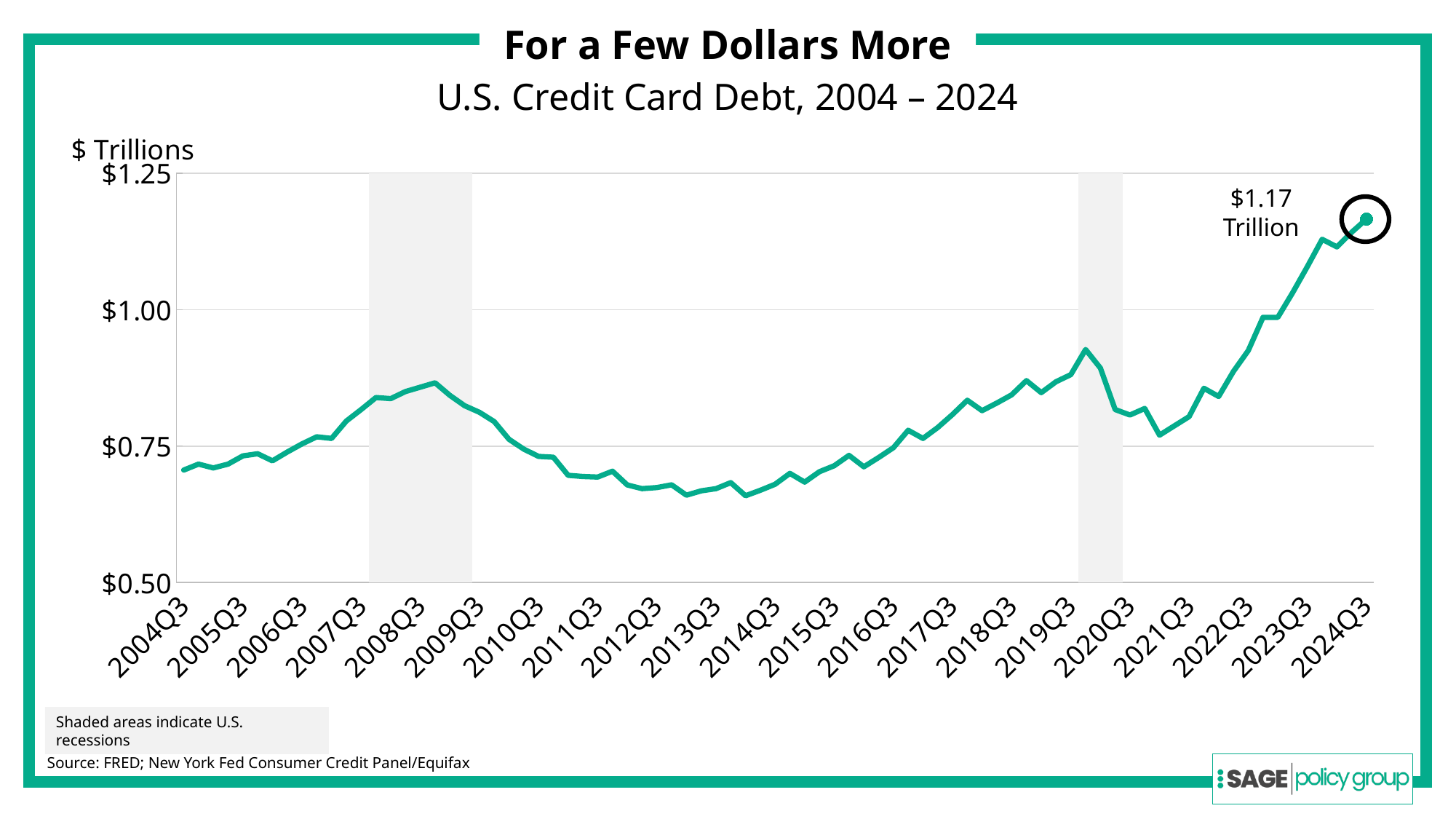
What kind of chart is shown on the slide? line chart Is the value for 2013Q3 greater or less than $0.75? less At which quarter on the x axis does the line reach its highest value? 2024Q3 Does the line rise or fall between 2020Q3 and 2024Q3? rise Is the value for 2008Q3 greater or less than $0.75? greater Which is larger, the value at 2008Q3 or the value at 2013Q3? 2008Q3 What do the shaded areas on the chart indicate? U.S. recessions How many quarter labels are shown on the x axis? 21 Is the value for 2004Q3 greater or less than $0.75? less What is the value of U.S. credit card debt at 2024Q3, as labeled on the chart? $1.17 Trillion